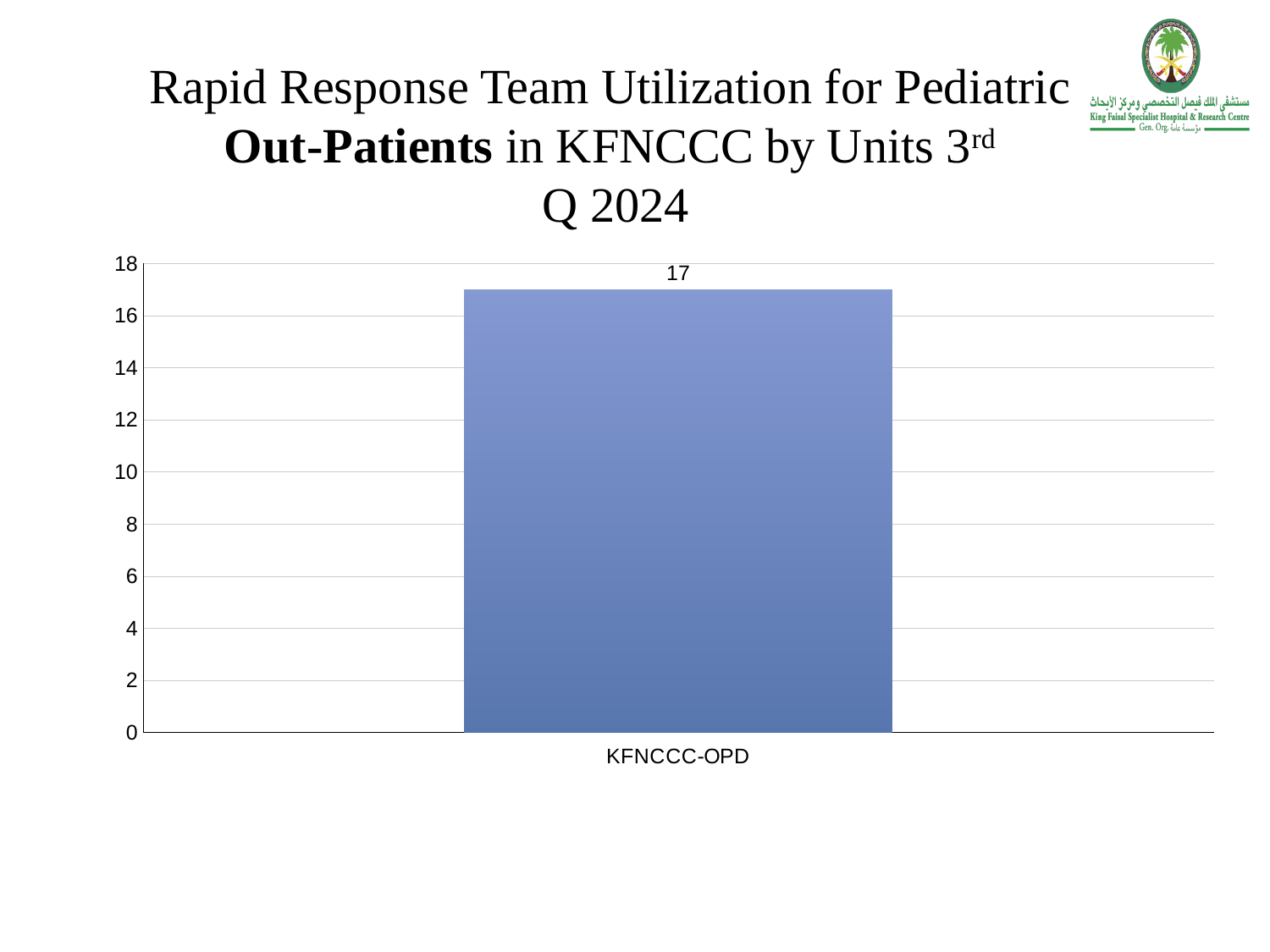
What kind of chart is shown on the slide? bar chart How many categories are shown on the x axis of the chart? 1 What is the label of the only category on the x axis? KFNCCC-OPD Which category has the highest value in the chart? KFNCCC-OPD Is the value for KFNCCC-OPD greater or less than 10? greater What is the value for KFNCCC-OPD? 17 What is the maximum value shown on the y axis? 18 Is the value for KFNCCC-OPD greater or less than 18? less